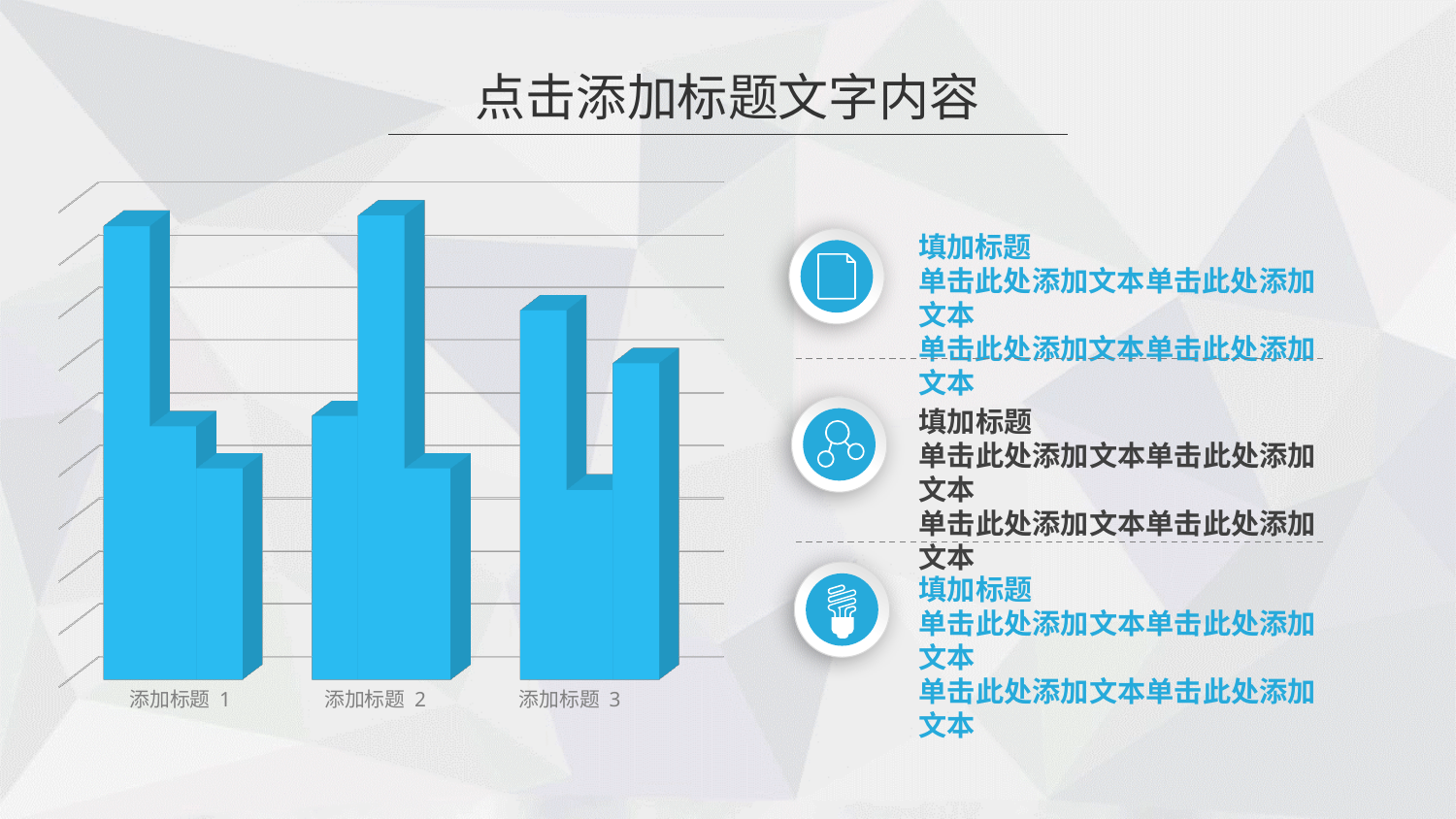
How many categories are shown on the x axis of the chart? 3 How many bars are plotted in total on the chart? 9 What kind of chart is shown on the slide? bar chart What colour are the bars in the chart? blue Within the 添加标题 1 group, which bar is the tallest: the first, second or third? the first Which is taller: the third bar of 添加标题 2 or the third bar of 添加标题 3? the third bar of 添加标题 3 What is the label of the leftmost category on the chart? 添加标题 1 Within the 添加标题 1 group, which bar is the shortest: the first, second or third? the third Within the 添加标题 3 group, which bar is the shortest: the first, second or third? the second Which is taller: the first bar of 添加标题 1 or the first bar of 添加标题 3? the first bar of 添加标题 1 Within the 添加标题 2 group, which bar is the tallest: the first, second or third? the second How many bars are plotted in each category group of the chart? 3